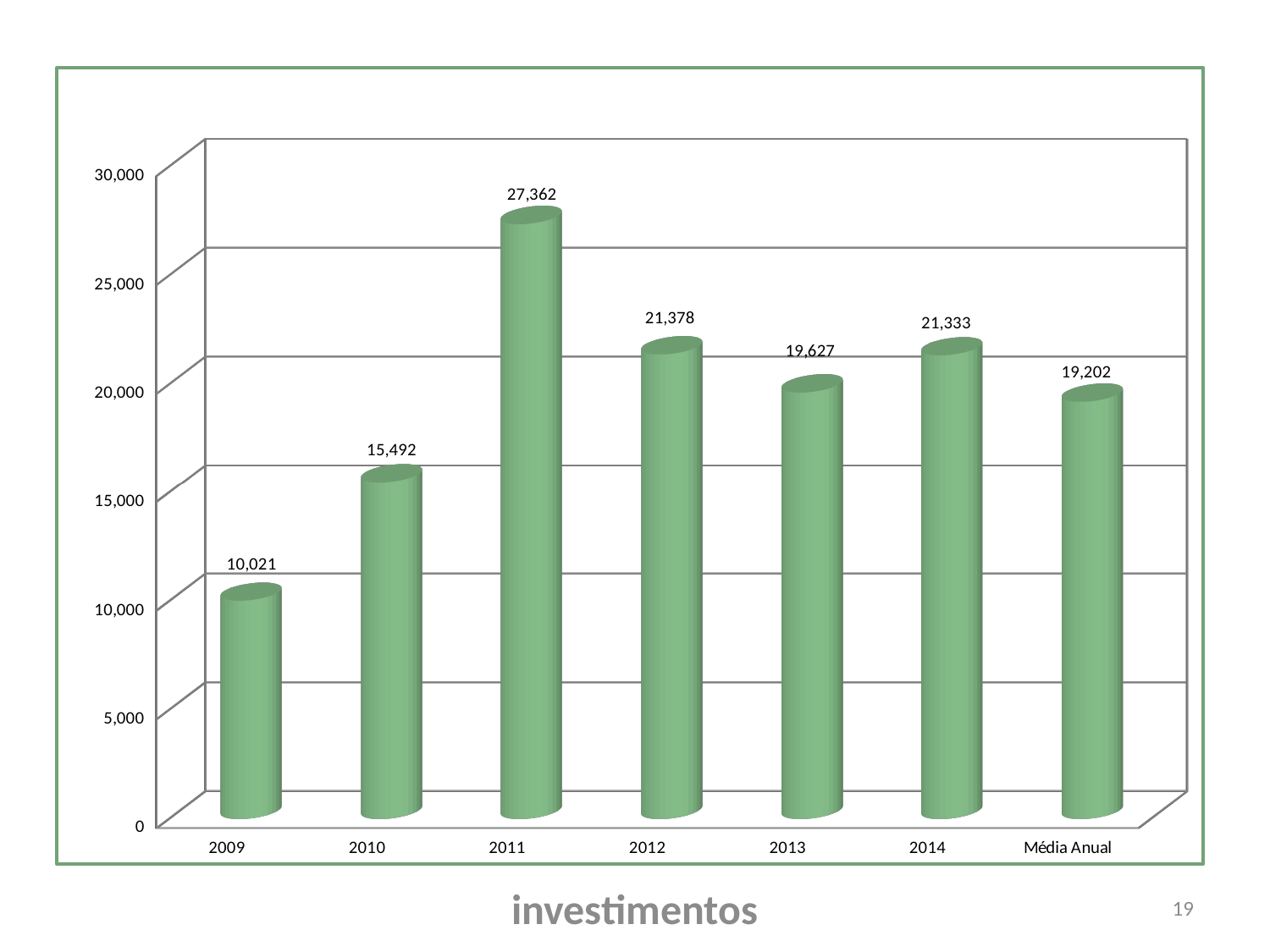
What is the difference between the values for 2012 and 2013? 1,751 What is the value for Média Anual? 19,202 What is the text shown below the chart? investimentos What is the value for 2009? 10,021 How many categories are shown on the x axis? 7 What is the difference between the values for 2011 and 2010? 11,870 Is the value for 2010 greater or less than 15,000? greater Which category has the highest value? 2011 What kind of chart is shown on the slide? bar chart Which category has the lowest value? 2009 Which is larger, the value for 2013 or the value for 2014? 2014 What is the value for 2011? 27,362